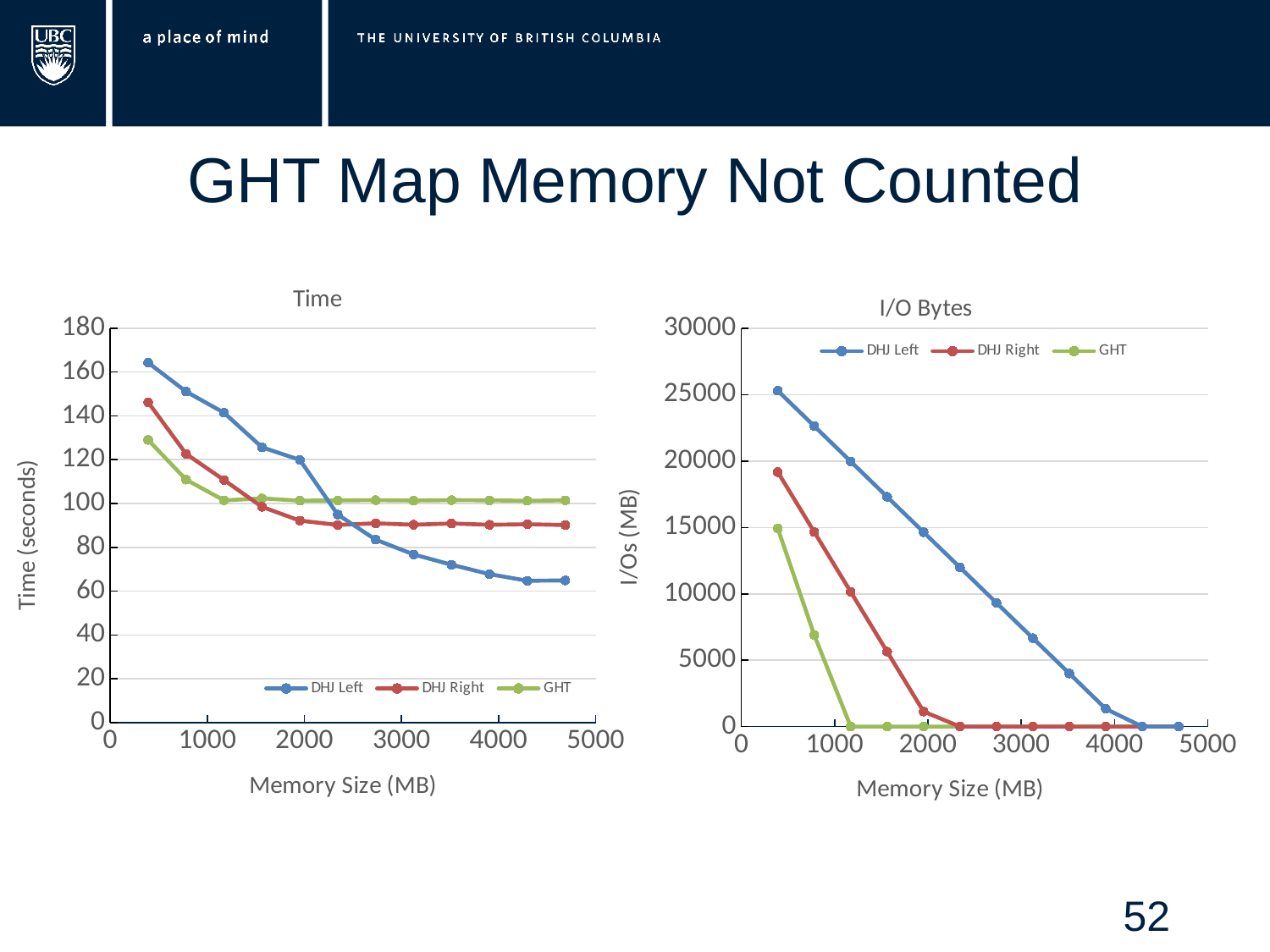
In the "I/O Bytes" chart, does the DHJ Left series rise or fall as memory size increases? fall How many series does the legend of the "I/O Bytes" chart list? 3 In the "Time" chart, is the last DHJ Left value (at the largest memory size) greater or less than 80? less In the "Time" chart, at a memory size of about 4000 MB, which series has the larger value: DHJ Left or DHJ Right? DHJ Right What kind of chart is the "Time" chart on the left? line chart In the "I/O Bytes" chart, what is the label of the x axis? Memory Size (MB) In the "I/O Bytes" chart, is the first DHJ Right value (at the smallest memory size) greater or less than 20000? less In the "Time" chart, is the first DHJ Left value (at the smallest memory size) greater or less than 140? greater In the "Time" chart, what is the label of the y axis? Time (seconds) In the "Time" chart, does the DHJ Left series rise or fall as memory size increases? fall In the "I/O Bytes" chart, which series has the highest value at the smallest memory size? DHJ Left